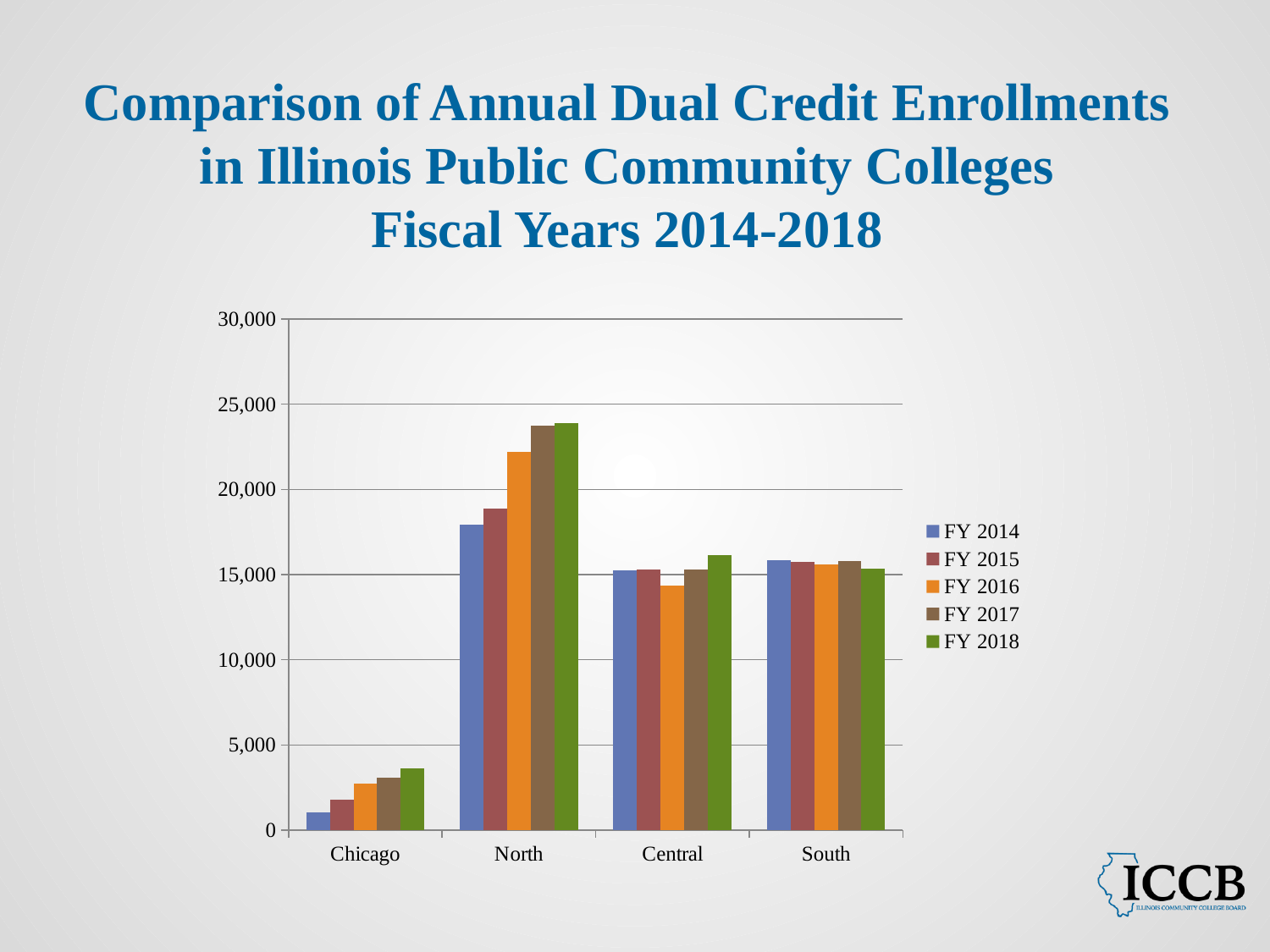
How many series does the legend list? 5 Do the Chicago enrollments rise or fall from FY 2014 to FY 2018? rise Is the value for North in FY 2017 greater or less than 20,000? greater Is the value for Chicago in FY 2018 greater or less than 5,000? less Which is larger for Chicago: the FY 2014 value or the FY 2018 value? FY 2018 Which is larger in FY 2016: the value for North or the value for Central? North Which region has the lowest dual credit enrollment in FY 2014? Chicago Which region has the highest dual credit enrollment in FY 2018? North Is the value for North in FY 2014 greater or less than 15,000? greater Which fiscal years are listed in the chart legend? FY 2014, FY 2015, FY 2016, FY 2017, FY 2018 How many regions are shown on the x axis of the chart? 4 What kind of chart is shown on the slide? Bar chart